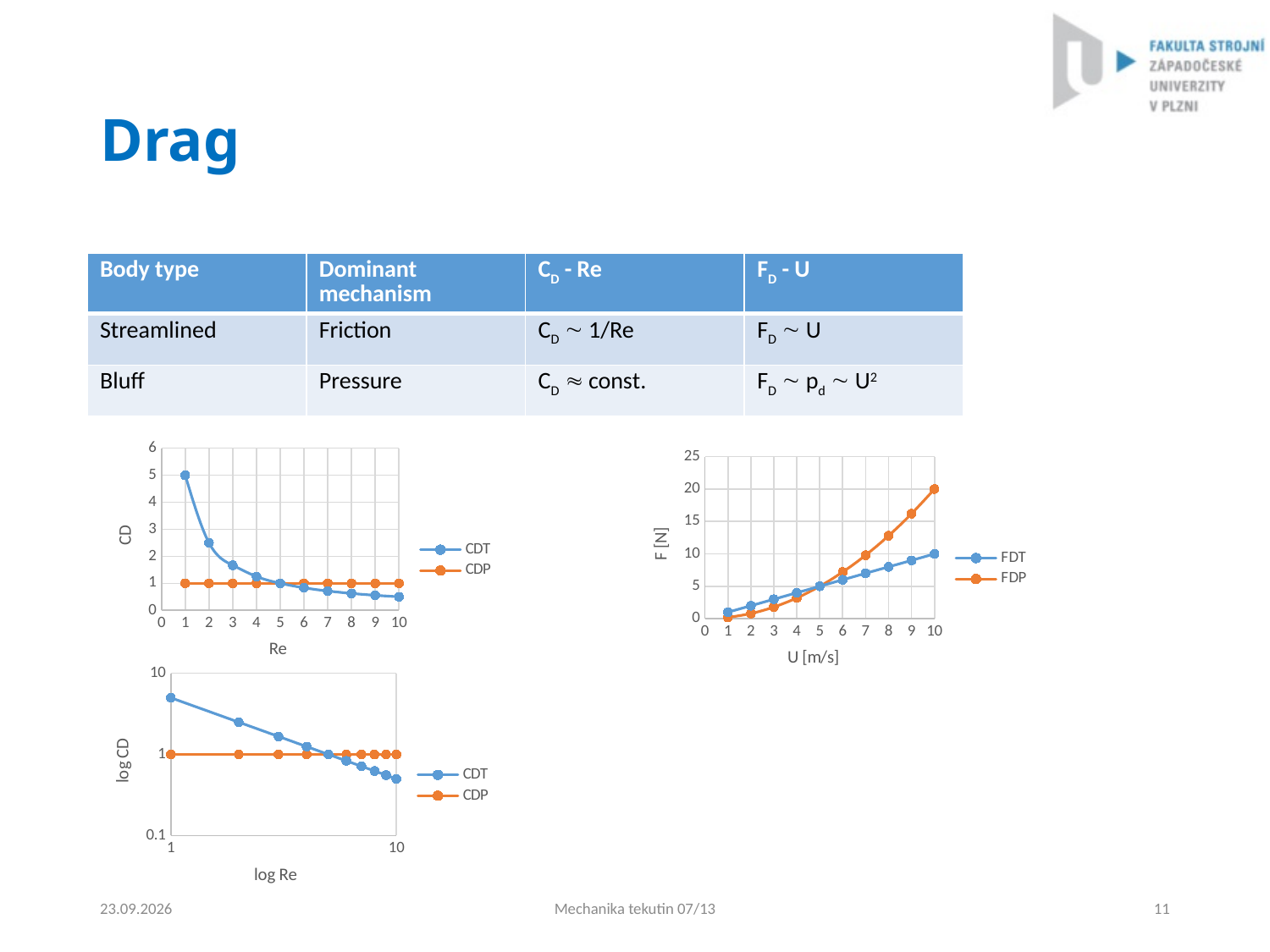
In the top-left chart (CD vs Re), is the value of CDT at Re = 2 greater or less than 2? greater In the top-left chart (CD vs Re), does the CDT series rise or fall as Re increases? fall In the top-left chart (CD vs Re), what type of chart is shown? line chart In the top-left chart (CD vs Re), what is the value of CDT at Re = 1? 5 In the bottom-left chart (log CD vs log Re), what is the label of the x axis? log Re In the right chart (F [N] vs U [m/s]), what is the difference between FDP and FDT at U = 10 m/s? 10 In the right chart (F [N] vs U [m/s]), does the FDP series rise or fall as U increases? rise In the top-left chart (CD vs Re), what is the value of CDP at Re = 5? 1 In the top-left chart (CD vs Re), how many series does the legend list? 2 In the right chart (F [N] vs U [m/s]), what is the value of FDT at U = 10 m/s? 10 In the right chart (F [N] vs U [m/s]), what is the value of FDP at U = 10 m/s? 20 In the bottom-left chart (log CD vs log Re), which series is higher at log Re = 10, CDT or CDP? CDP